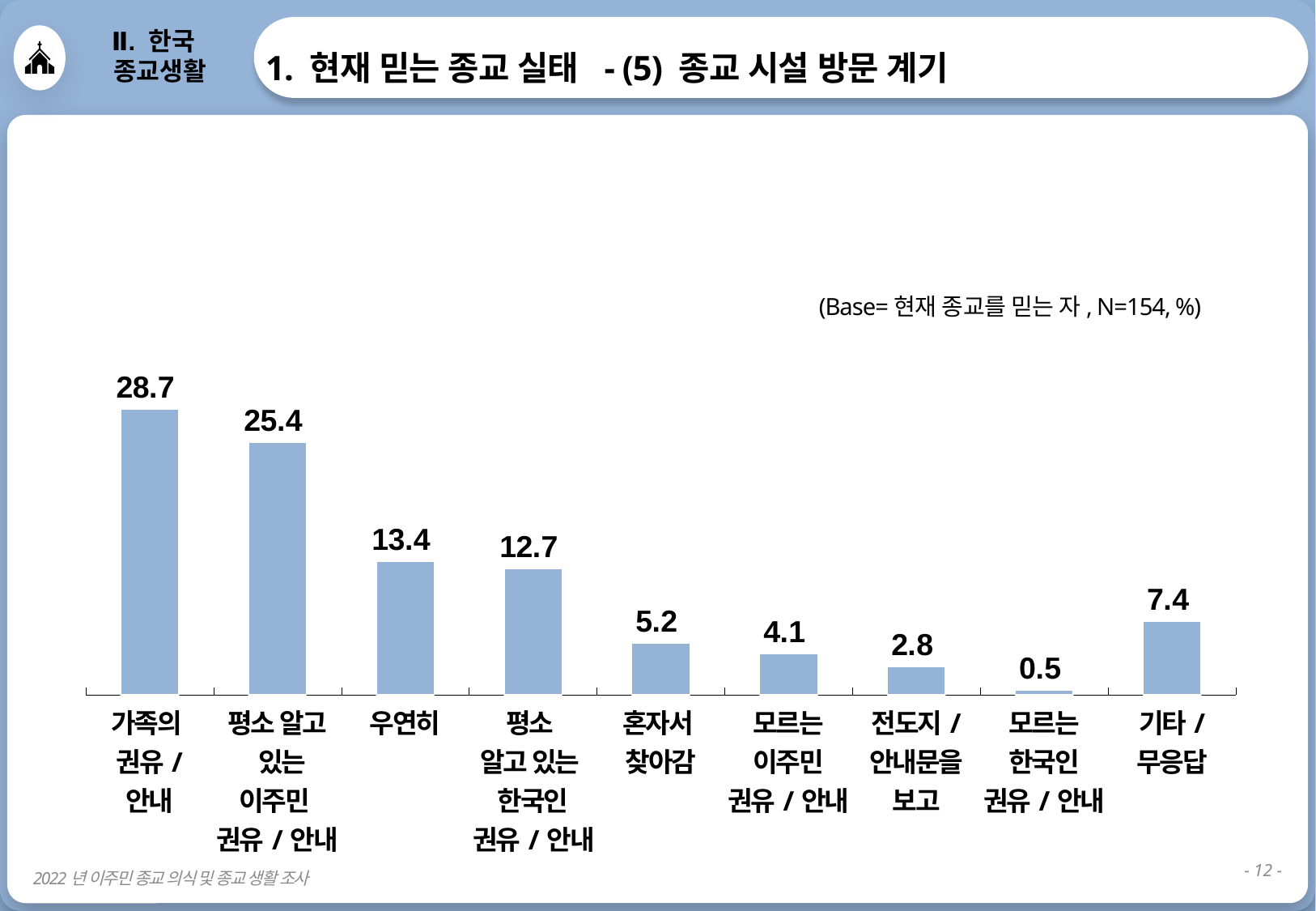
What is the difference between 가족의 권유 / 안내 and 평소 알고 있는 이주민 권유 / 안내? 3.3 What is the value for 기타 / 무응답? 7.4 What kind of chart is shown on the slide? Bar chart What is the base (N) stated for the chart? N=154 Which category has the lowest value? 모르는 한국인 권유 / 안내 How many categories are shown in the chart? 9 What is the value for 우연히? 13.4 What is the difference between 우연히 and 평소 알고 있는 한국인 권유 / 안내? 0.7 Which category has the highest value? 가족의 권유 / 안내 What is the value for 가족의 권유 / 안내? 28.7 Which is larger, 혼자서 찾아감 or 모르는 이주민 권유 / 안내? 혼자서 찾아감 What is the value for 전도지 / 안내문을 보고? 2.8